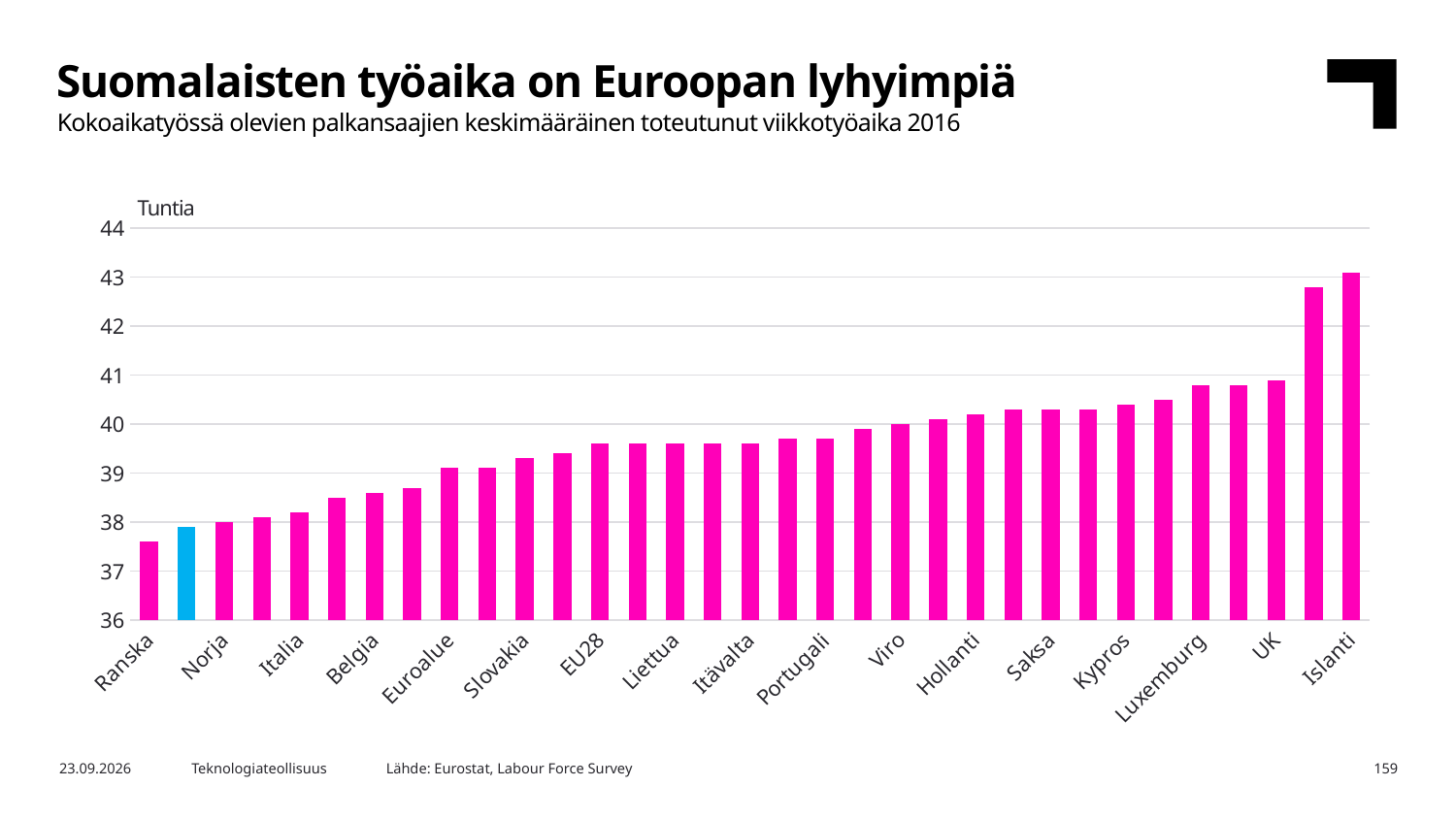
What kind of chart is shown on the slide? bar chart Do the values rise or fall from left to right along the x axis? rise Is the value for Saksa greater or less than 40? greater Is the value for Ranska greater or less than 38? less Is the value for Belgia greater or less than 39? less What unit is shown at the top of the vertical axis? Tuntia Which is larger, the value for Luxemburg or the value for Belgia? Luxemburg Which category has the highest value in the chart? Islanti Which category has the lowest value in the chart? Ranska How many bars are plotted in the chart? 33